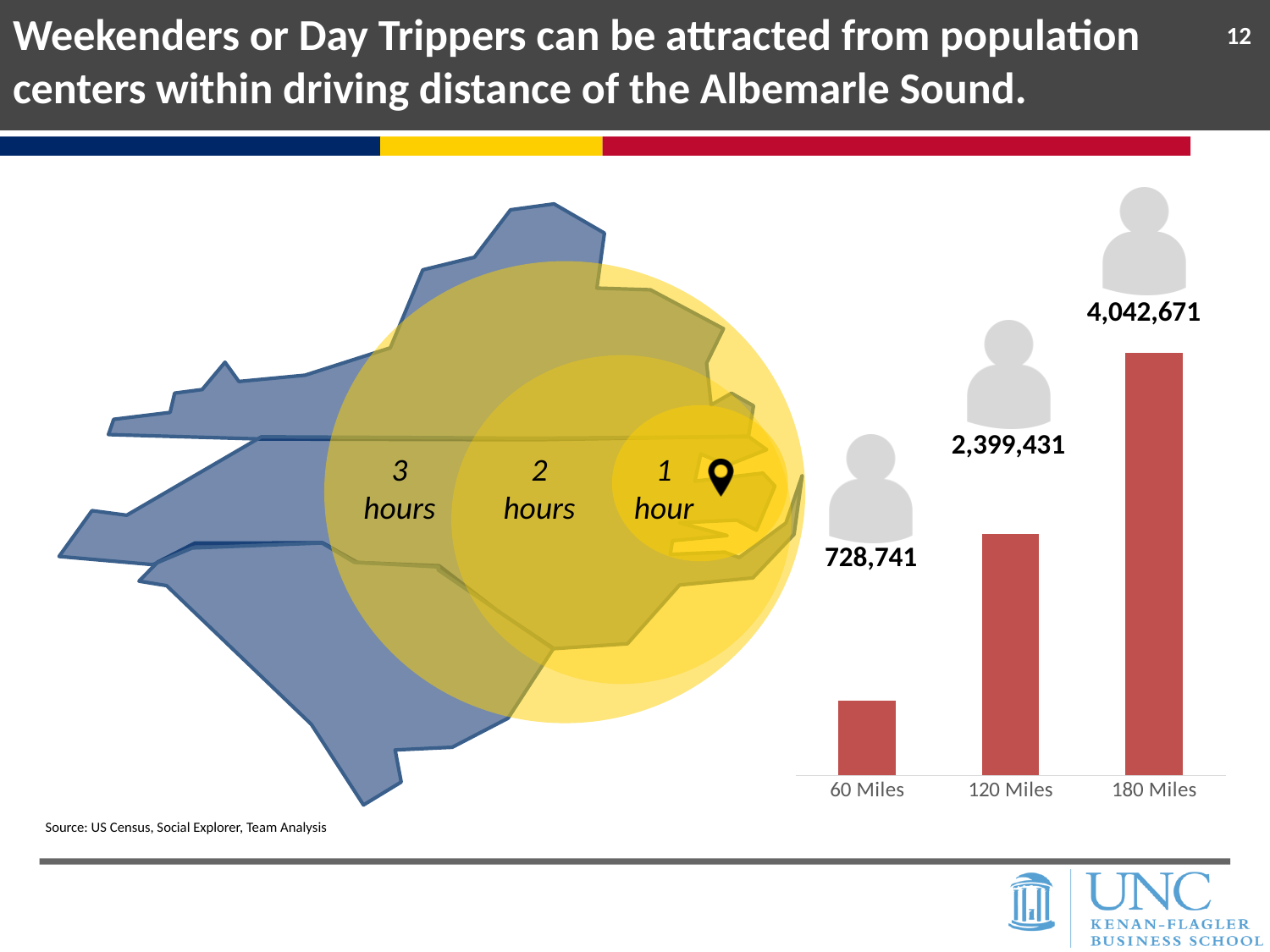
Which is larger, the value for 120 Miles or the value for 60 Miles? 120 Miles Which distance category has the lowest value? 60 Miles What is the difference between the values for 180 Miles and 60 Miles? 3,313,930 What is the difference between the values for 120 Miles and 60 Miles? 1,670,690 What kind of chart is shown on the right side of the slide? Bar chart Do the values rise or fall as the distance increases from 60 Miles to 180 Miles? Rise What is the value shown for 60 Miles? 728,741 What is the value shown for 120 Miles? 2,399,431 What is the difference between the values for 180 Miles and 120 Miles? 1,643,240 How many distance categories are shown in the bar chart? 3 Which distance category has the highest value? 180 Miles What is the value shown for 180 Miles? 4,042,671